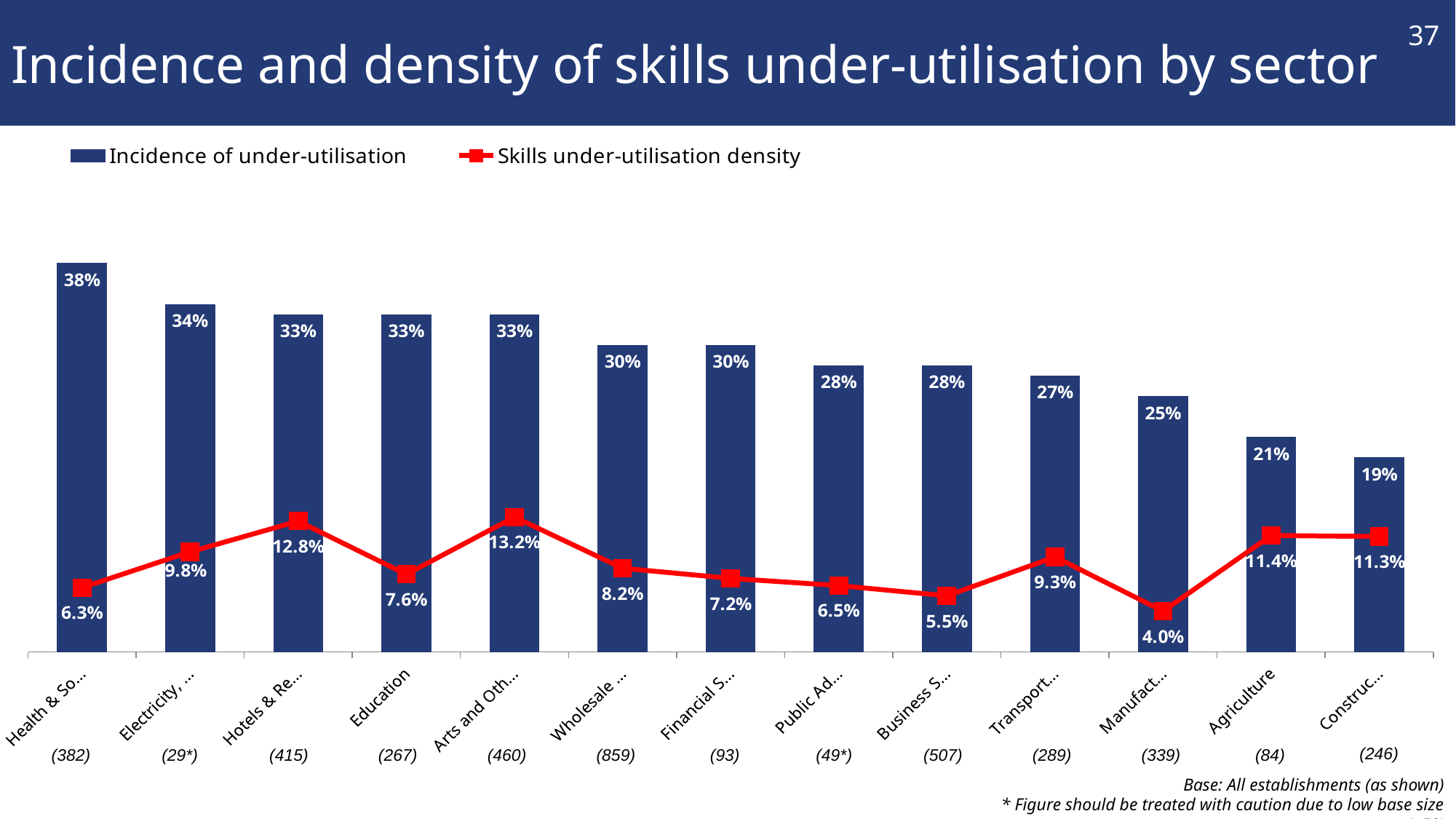
What is the difference in Incidence of under-utilisation between Education and Agriculture? 12 percentage points What is the highest Incidence of under-utilisation value shown on the chart? 38% Do the Incidence of under-utilisation bars rise or fall from left to right across the x axis? Fall What kind of chart is shown on the slide? A bar chart combined with a line chart What is the lowest Incidence of under-utilisation value shown on the chart? 19% How many sectors are shown on the x axis of the chart? 13 What is the lowest Skills under-utilisation density value shown on the chart? 4.0% What is the Incidence of under-utilisation for Education? 33% What is the Skills under-utilisation density for Agriculture? 11.4% Which has the higher Skills under-utilisation density, Education or Agriculture? Agriculture How many series does the legend list? 2 What is the difference in Skills under-utilisation density between Agriculture and Education? 3.8 percentage points